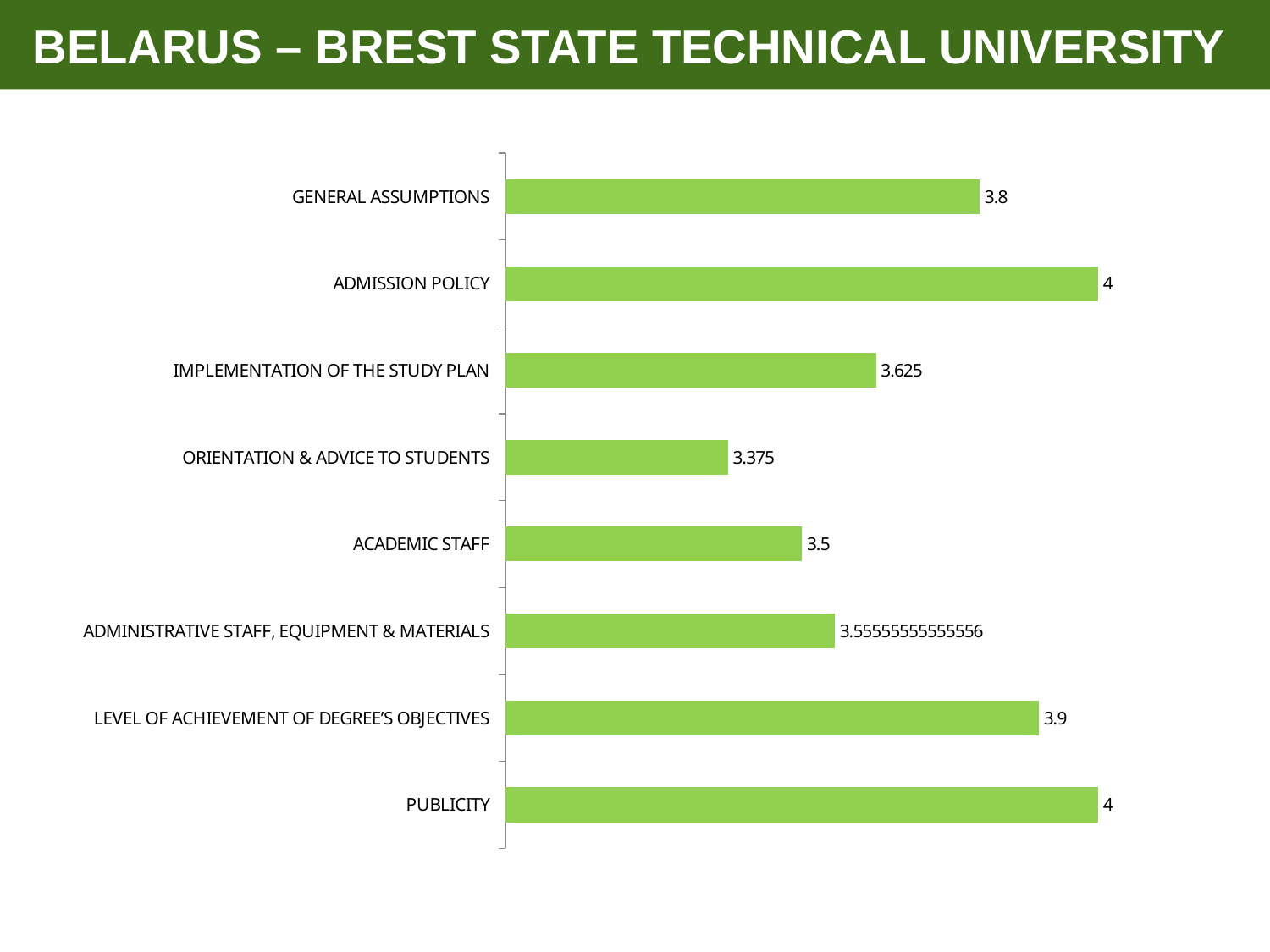
What is the value for ADMINISTRATIVE STAFF, EQUIPMENT & MATERIALS? 3.55555555555556 What is the value for ORIENTATION & ADVICE TO STUDENTS? 3.375 What is the difference between the values for GENERAL ASSUMPTIONS and ORIENTATION & ADVICE TO STUDENTS? 0.425 What is the value for LEVEL OF ACHIEVEMENT OF DEGREE'S OBJECTIVES? 3.9 What is the difference between the values for ADMISSION POLICY and ACADEMIC STAFF? 0.5 What is the value for GENERAL ASSUMPTIONS? 3.8 How many categories are shown in the chart? 8 What is the value for ACADEMIC STAFF? 3.5 What is the value for IMPLEMENTATION OF THE STUDY PLAN? 3.625 Which category has the lowest value? ORIENTATION & ADVICE TO STUDENTS Which is larger, the value for LEVEL OF ACHIEVEMENT OF DEGREE'S OBJECTIVES or the value for IMPLEMENTATION OF THE STUDY PLAN? LEVEL OF ACHIEVEMENT OF DEGREE'S OBJECTIVES What kind of chart is shown on the slide? Bar chart